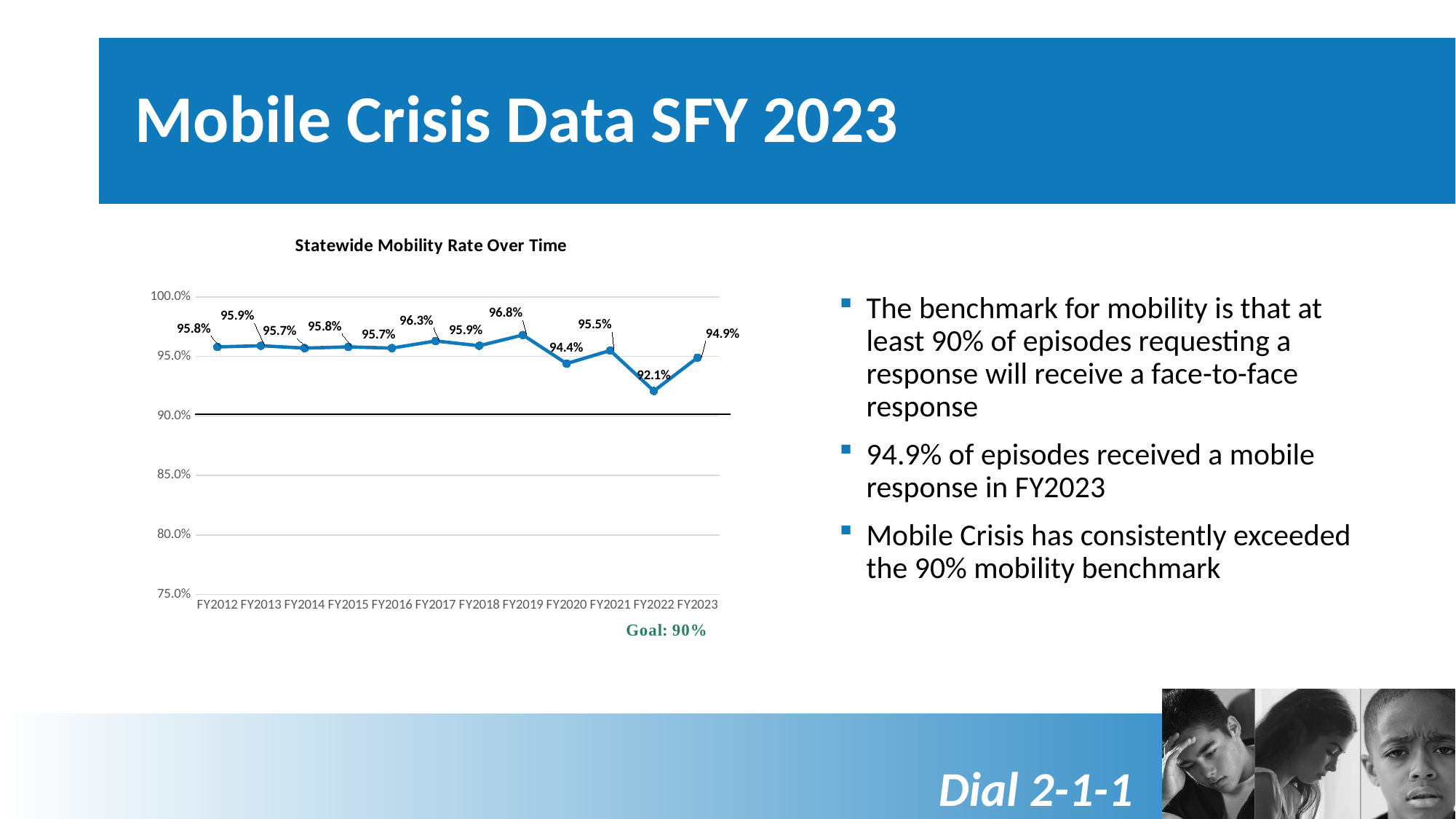
What goal value is labeled below the chart? Goal: 90% Which is larger, the mobility rate for FY2020 or for FY2021? FY2021 How many fiscal years are plotted on the x axis? 12 Is the value for FY2022 greater or less than 90%? greater What type of chart is shown on the slide? line chart What is the mobility rate for FY2022? 92.1% What is the title of the chart? Statewide Mobility Rate Over Time What is the mobility rate for FY2023? 94.9% What is the mobility rate for FY2019? 96.8% Which fiscal year has the lowest mobility rate? FY2022 Which fiscal year has the highest mobility rate? FY2019 What is the difference between the mobility rates for FY2019 and FY2022? 4.7%